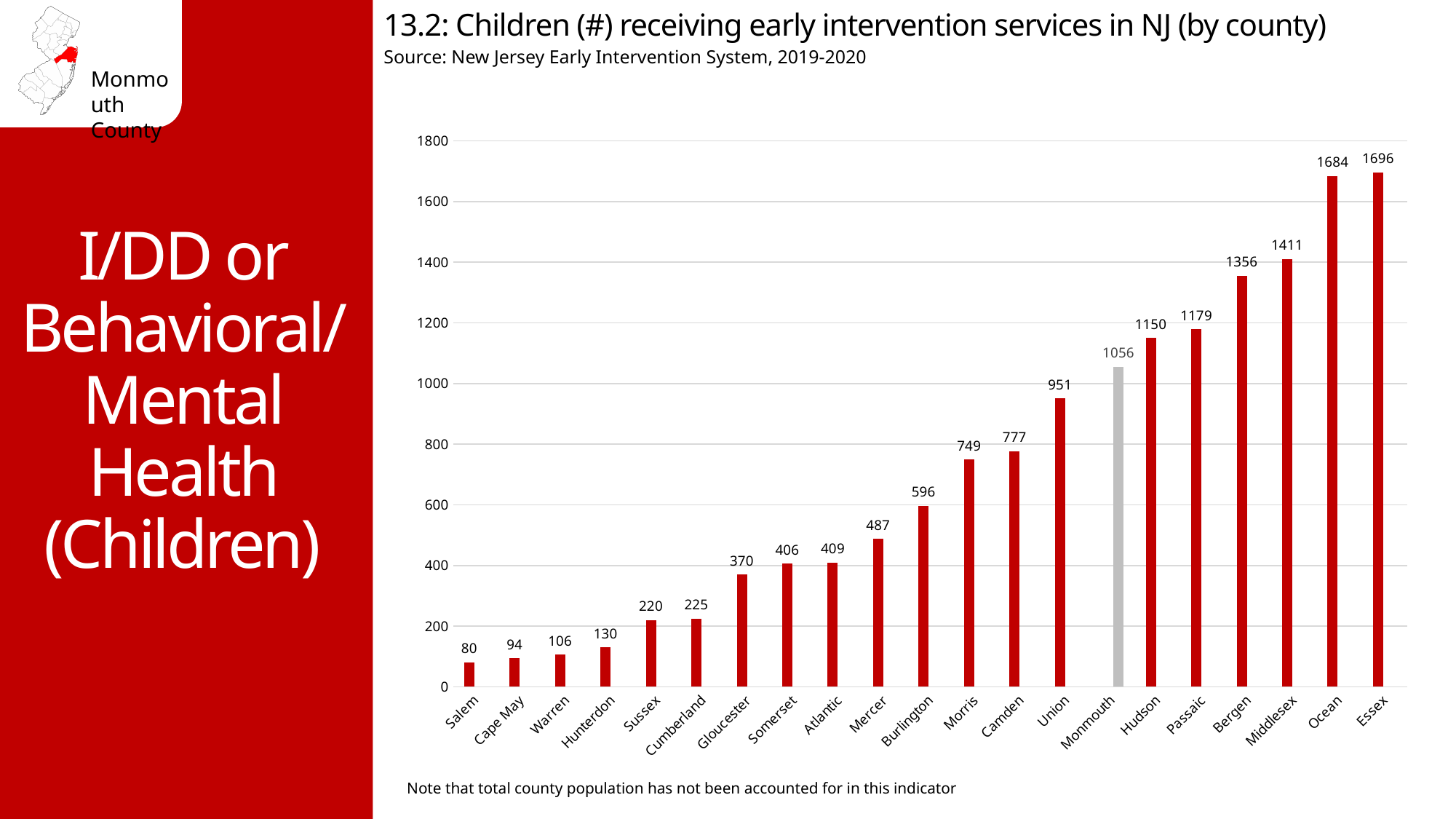
Do the values rise or fall moving from left to right along the x axis? rise What is the difference between the values for Essex and Ocean? 12 Is the value for Union greater or less than 1000? less What is the value shown for Mercer? 487 What is the difference between the values for Hudson and Monmouth? 94 What kind of chart is shown on the slide? bar chart Which county has the highest number of children receiving early intervention services? Essex Which county's bar is coloured grey instead of red? Monmouth Which county has the lowest number of children receiving early intervention services? Salem Which has a higher value, Bergen or Passaic? Bergen How many children received early intervention services in Monmouth County? 1056 How many counties are shown on the x axis? 21